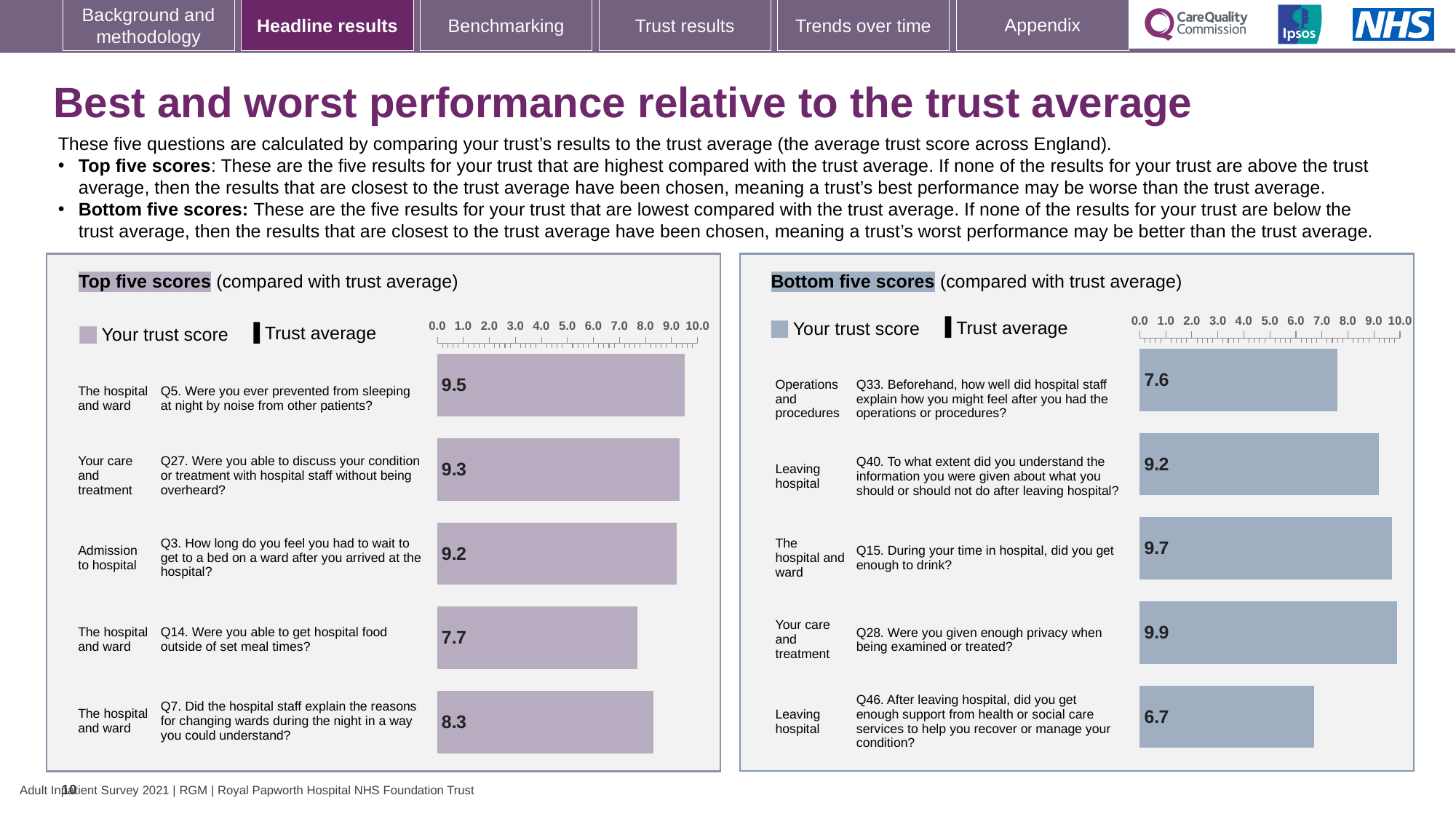
How many questions are shown in the Bottom five scores chart? 5 In the Bottom five scores chart, what is the trust score for Q28 (given enough privacy when being examined or treated)? 9.9 In the Bottom five scores chart, which question has the highest trust score? Q28 What type of chart is used in the Top five scores panel? Bar chart In the Bottom five scores chart, which has the larger trust score, Q33 or Q40? Q40 In the Bottom five scores chart, what is the trust score for Q46 (enough support from health or social care services after leaving hospital)? 6.7 In the Top five scores chart, which question has the lowest trust score? Q14 In the Top five scores chart, what is the trust score for Q5 (prevented from sleeping at night by noise from other patients)? 9.5 In the Bottom five scores chart, which question has the lowest trust score? Q46 In the Top five scores chart, what is the trust score for Q14 (able to get hospital food outside of set meal times)? 7.7 In the Top five scores chart, which question has the highest trust score? Q5 In the Top five scores chart, what is the difference between the trust scores for Q5 and Q14? 1.8